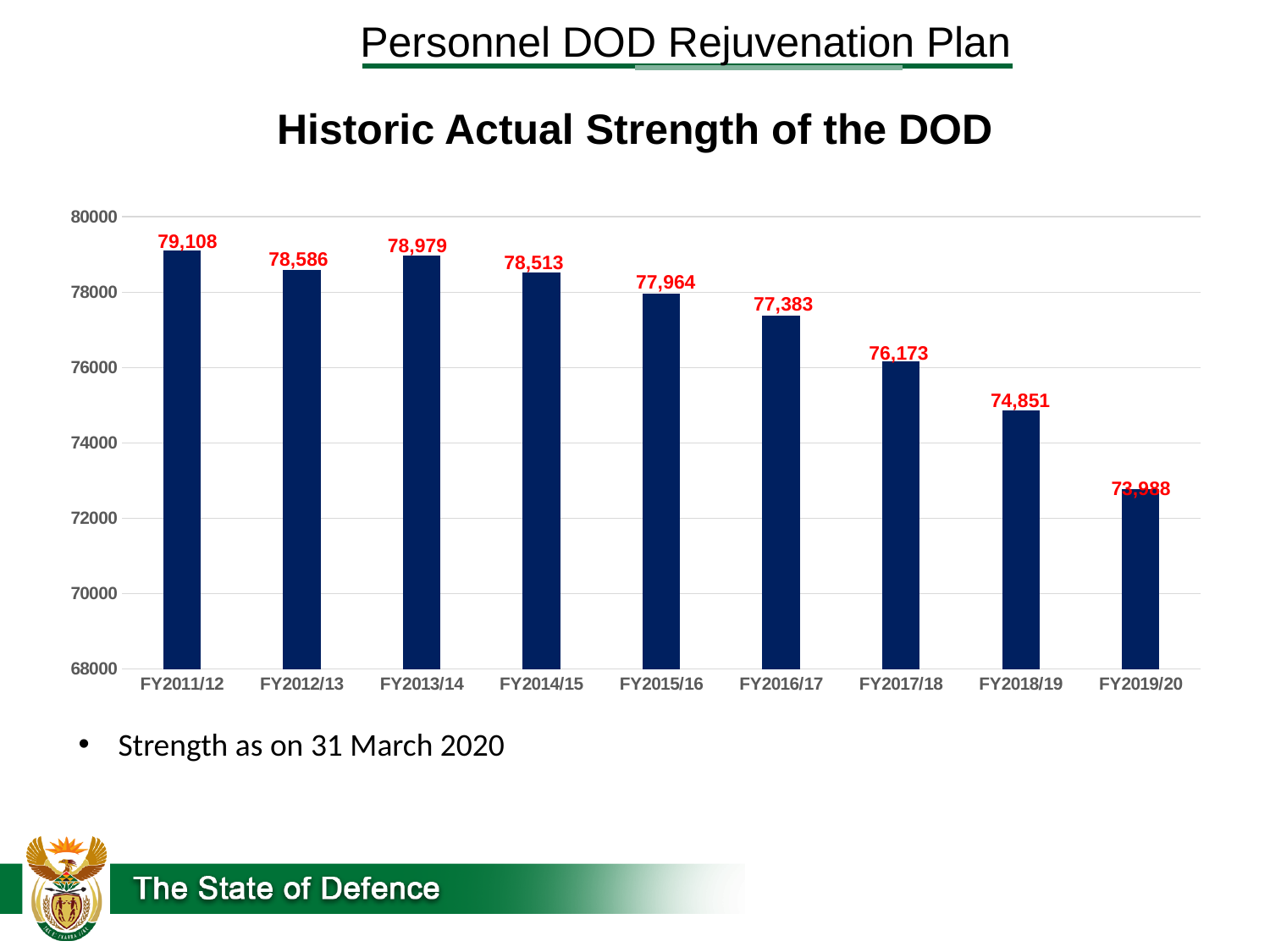
What is the title of the chart? Historic Actual Strength of the DOD What type of chart is shown on the slide? bar chart What was the actual strength of the DOD in FY2015/16? 77,964 What was the actual strength of the DOD in FY2011/12? 79,108 Which financial year has the highest actual strength? FY2011/12 What is the difference in actual strength between FY2011/12 and FY2018/19? 4,257 Is the value for FY2019/20 greater or less than 74000? less How many financial years are shown on the x axis of the chart? 9 Do the values generally rise or fall from FY2011/12 to FY2019/20? fall Which is larger, the actual strength in FY2012/13 or in FY2013/14? FY2013/14 Which financial year has the lowest actual strength? FY2019/20 What was the actual strength of the DOD in FY2018/19? 74,851